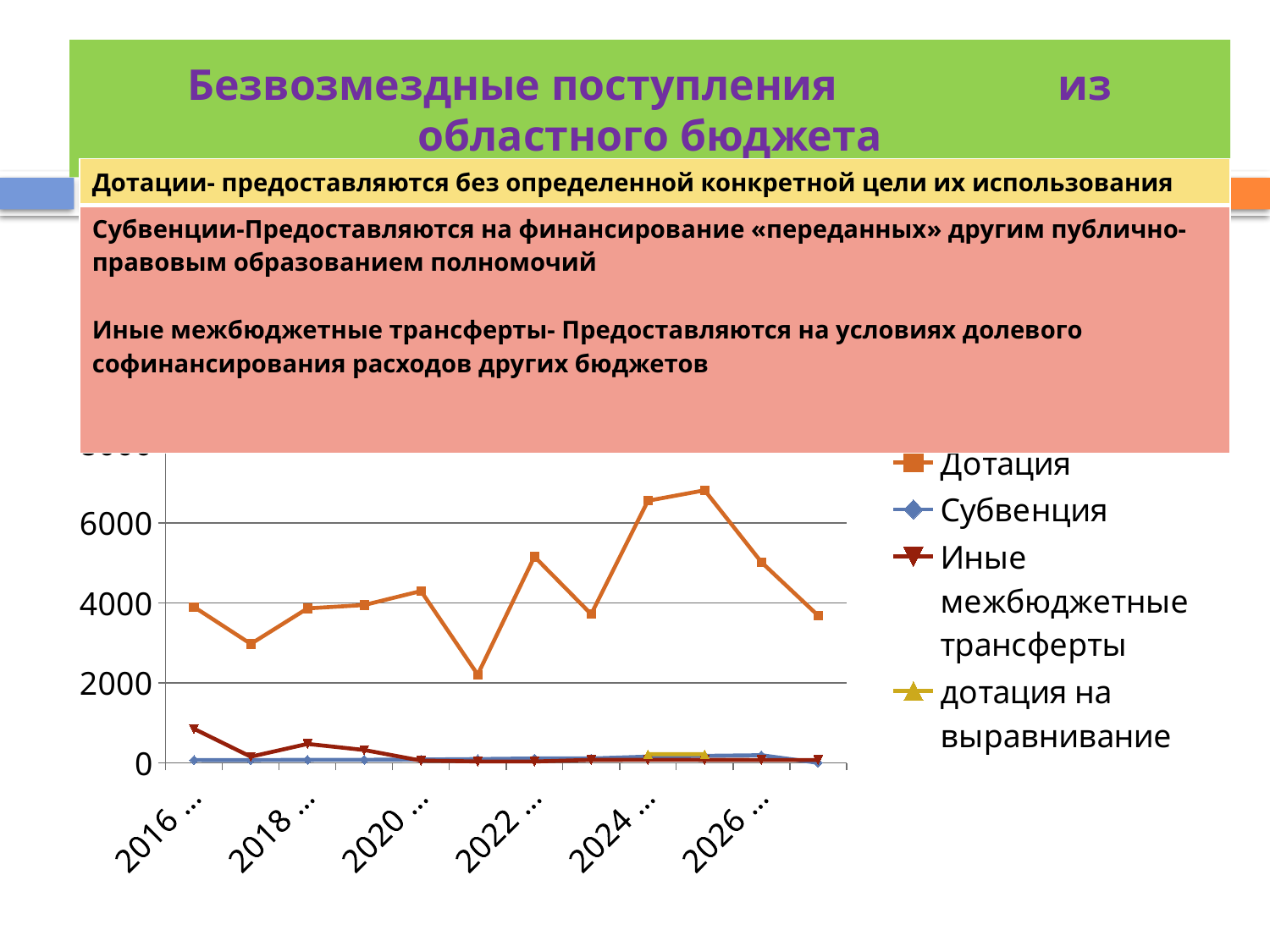
How many series does the chart legend list? 4 Is the value for Дотация in 2026 greater or less than 6000? less Is the value for Дотация in 2024 greater or less than 6000? greater Is the value for Дотация higher in 2024 or in 2026? 2024 Is the value for Дотация in 2022 greater or less than 4000? greater Is the value for Дотация higher in 2020 or in 2022? 2022 What kind of chart is shown on the slide? line chart How many year labels are shown on the x axis? 6 What colour is the Дотация line in the chart? orange Which series has the highest values across the chart? Дотация